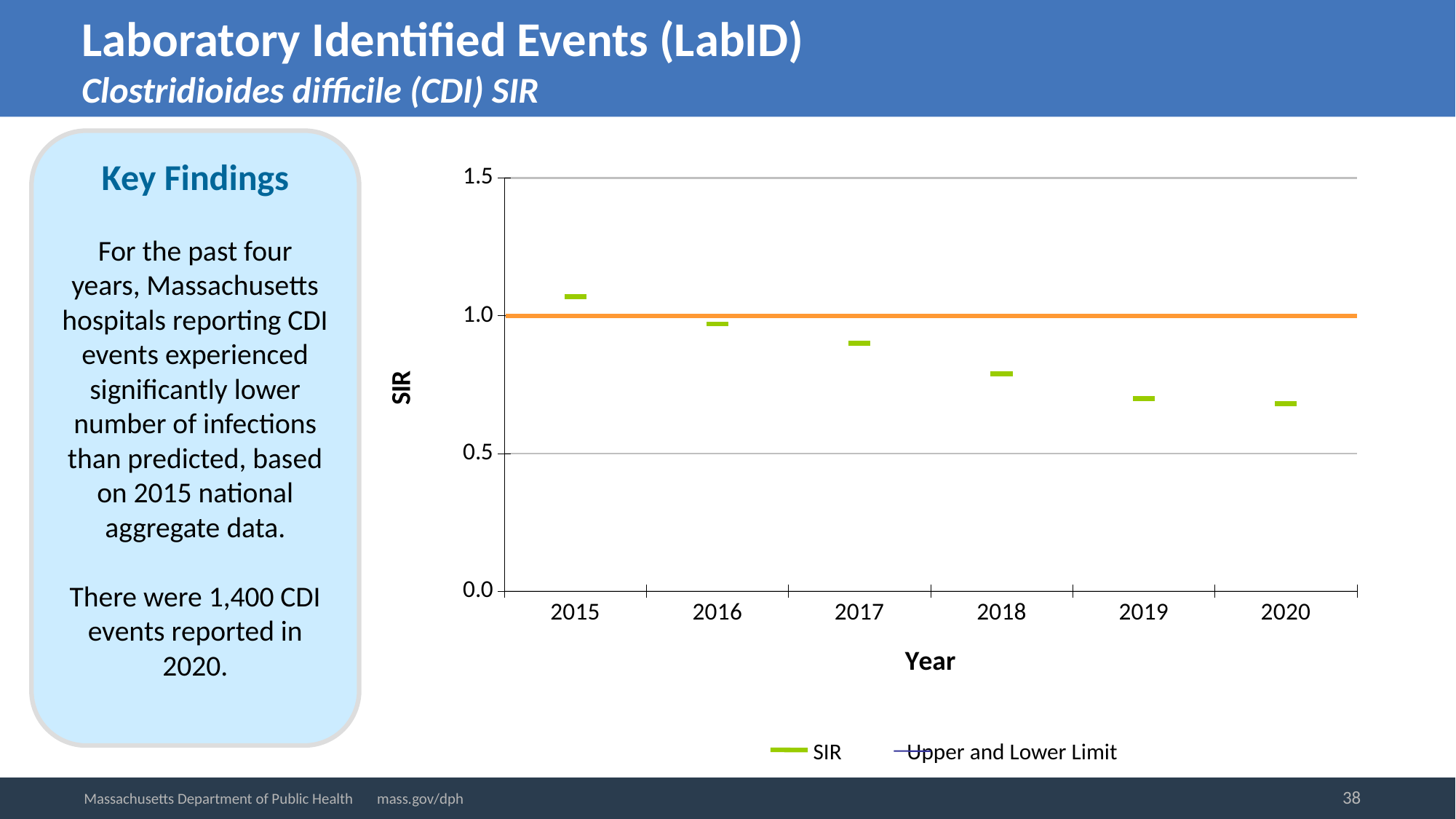
How many years are plotted on the x axis? 6 Is the SIR value for 2020 greater or less than 0.5? greater Which is larger, the SIR for 2015 or the SIR for 2018? 2015 How many series does the legend list? 2 Which is larger, the SIR for 2017 or the SIR for 2019? 2017 Which year has the highest SIR value? 2015 Is the SIR value for 2015 greater or less than 1.0? greater Do the SIR values rise or fall from 2015 to 2020? fall Is the SIR value for 2018 greater or less than 1.0? less What are the two entries in the chart legend? SIR; Upper and Lower Limit What is the label on the y axis of the chart? SIR